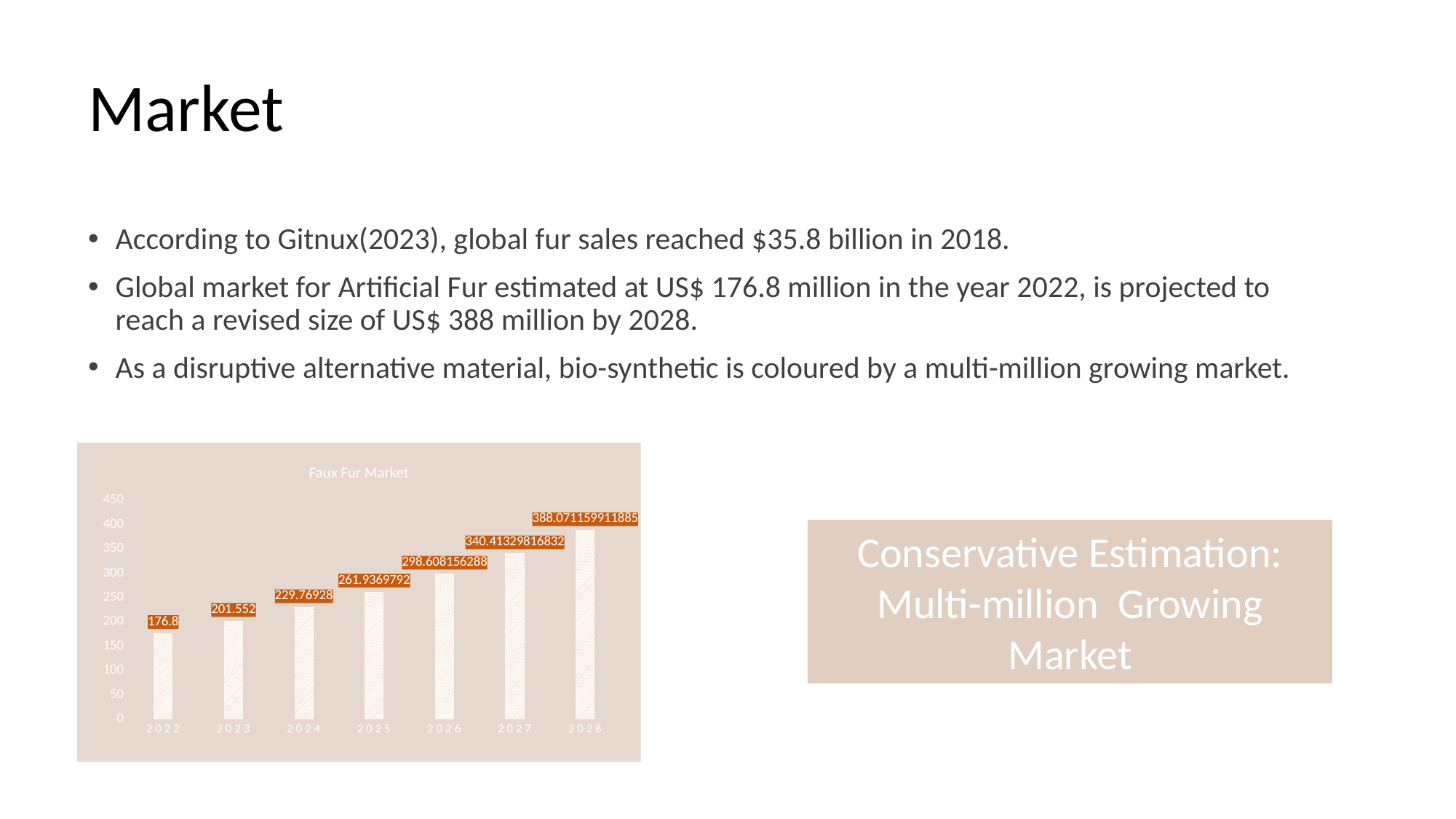
What is the title of the chart? Faux Fur Market What is the value for 2023 in the Faux Fur Market chart? 201.552 What is the difference between the values for 2023 and 2022 in the Faux Fur Market chart? 24.752 Which year has the highest value in the Faux Fur Market chart? 2028 What is the value for 2028 in the Faux Fur Market chart? 388.071159911885 Which is larger in the Faux Fur Market chart, the value for 2026 or the value for 2024? 2026 What is the value for 2025 in the Faux Fur Market chart? 261.9369792 Which year has the lowest value in the Faux Fur Market chart? 2022 How many years are shown on the x axis of the Faux Fur Market chart? 7 What kind of chart is shown on the slide? bar chart What is the value for 2022 in the Faux Fur Market chart? 176.8 Do the values in the Faux Fur Market chart rise or fall from 2022 to 2028? rise